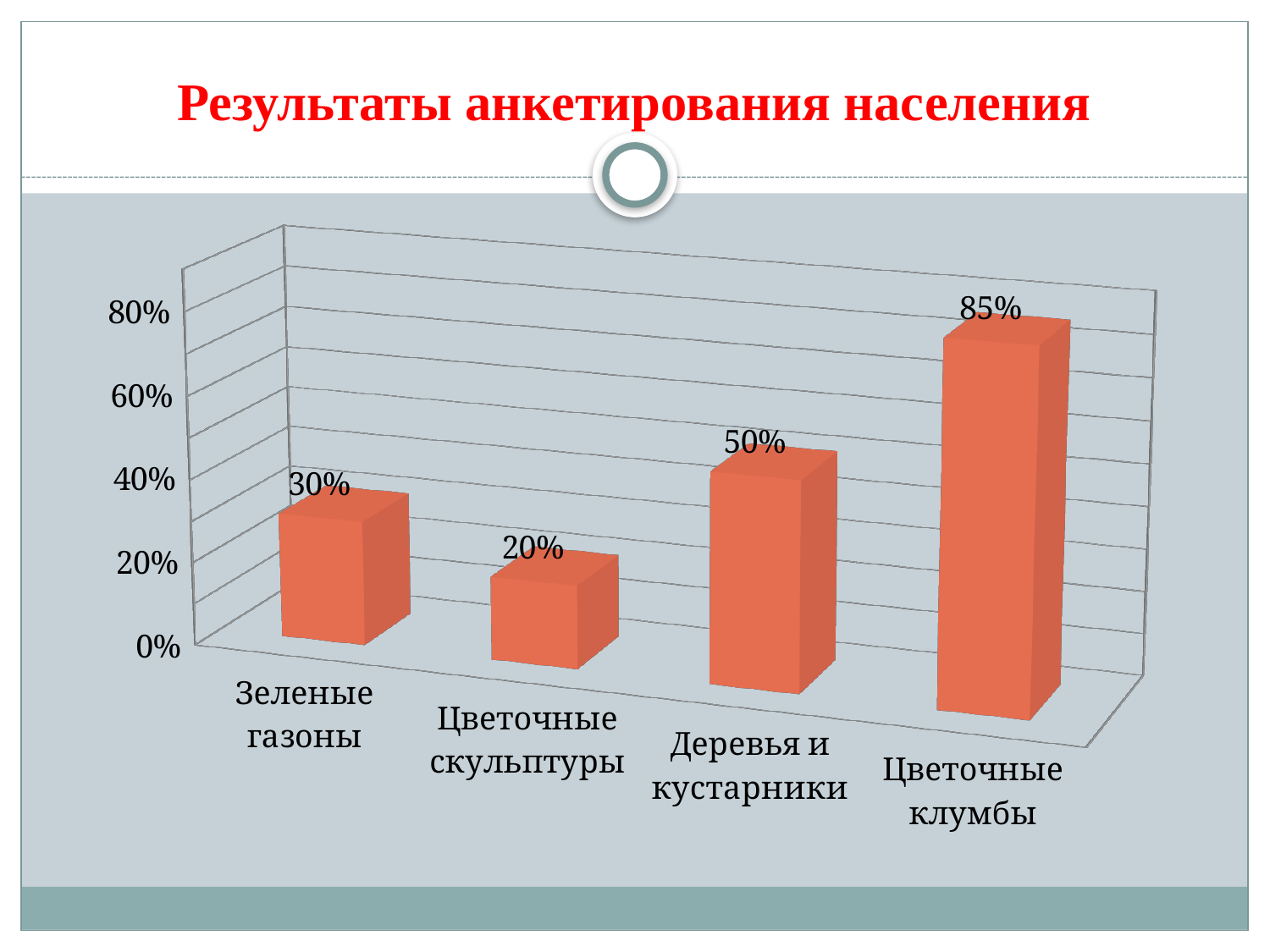
What is the value for Деревья и кустарники? 50% Which is larger, the value for Зеленые газоны or the value for Деревья и кустарники? Деревья и кустарники Which category has the highest value? Цветочные клумбы What is the value for Цветочные клумбы? 85% What is the difference between the values for Цветочные клумбы and Деревья и кустарники? 35% What kind of chart is shown on the slide? Bar chart What is the value for Цветочные скульптуры? 20% What is the title of the slide? Результаты анкетирования населения Which category has the lowest value? Цветочные скульптуры What is the difference between the values for Зеленые газоны and Цветочные скульптуры? 10% How many categories are shown in the chart? 4 What is the value for Зеленые газоны? 30%